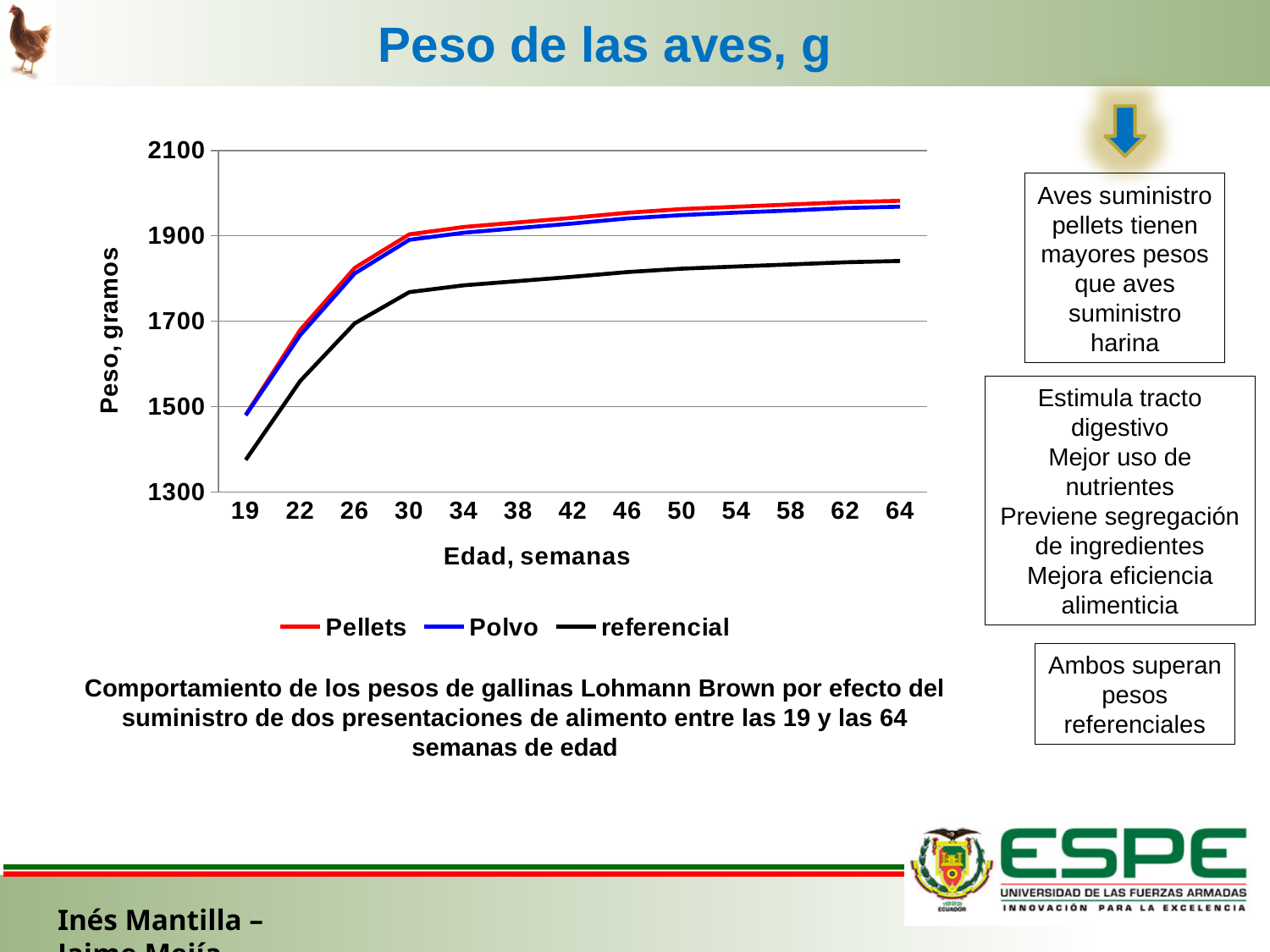
What kind of chart is shown on the slide? line chart How many series does the legend list? 3 How many age points (weeks) are shown along the x axis? 13 Is the value for Pellets at 64 weeks greater or less than 1900? greater What is the label of the y axis? Peso, gramos Is the value for referencial at 64 weeks greater or less than 1900? less Is the value for referencial at 30 weeks greater or less than 1700? greater At 64 weeks, which is larger: the value for Pellets or the value for referencial? Pellets Do the weights rise or fall as age in weeks increases? rise Which series has the lowest weight across all ages? referencial